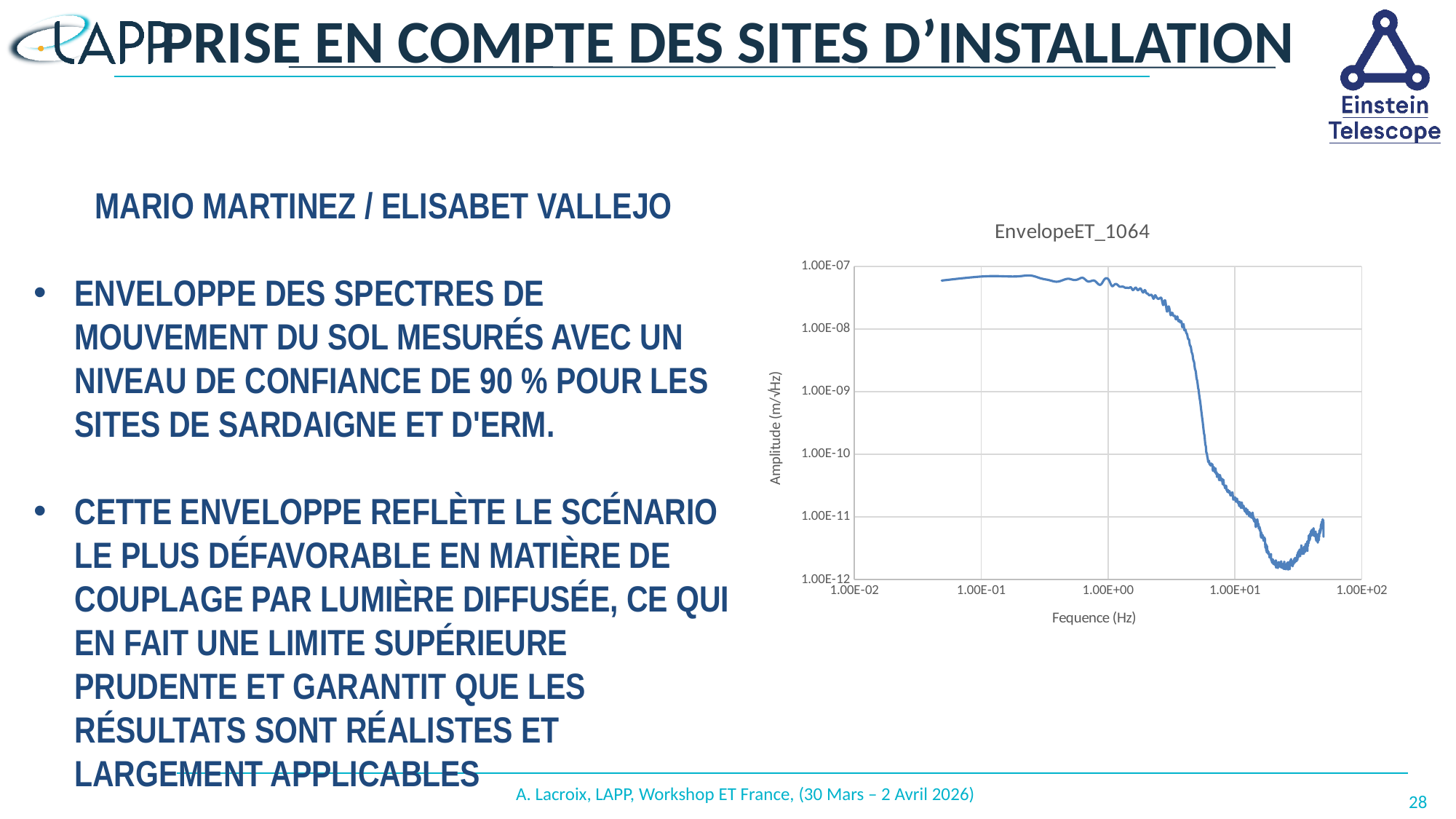
What is the label of the y axis of the chart? Amplitude (m/√Hz) What kind of chart is shown on the slide? line chart Is the amplitude at 1.00E+00 Hz greater or less than 1.00E-08? greater Is the amplitude at 1.00E-01 Hz greater or less than 1.00E-07? less Is the lowest amplitude reached by the curve greater or less than 1.00E-11? less How many lines are plotted on the chart? 1 Overall, does the amplitude rise or fall as frequency increases along the x axis? fall What is the title of the chart? EnvelopeET_1064 What is the highest value shown on the y axis of the chart? 1.00E-07 Which is larger: the amplitude at 1.00E-01 Hz or the amplitude at 1.00E+01 Hz? 1.00E-01 Hz